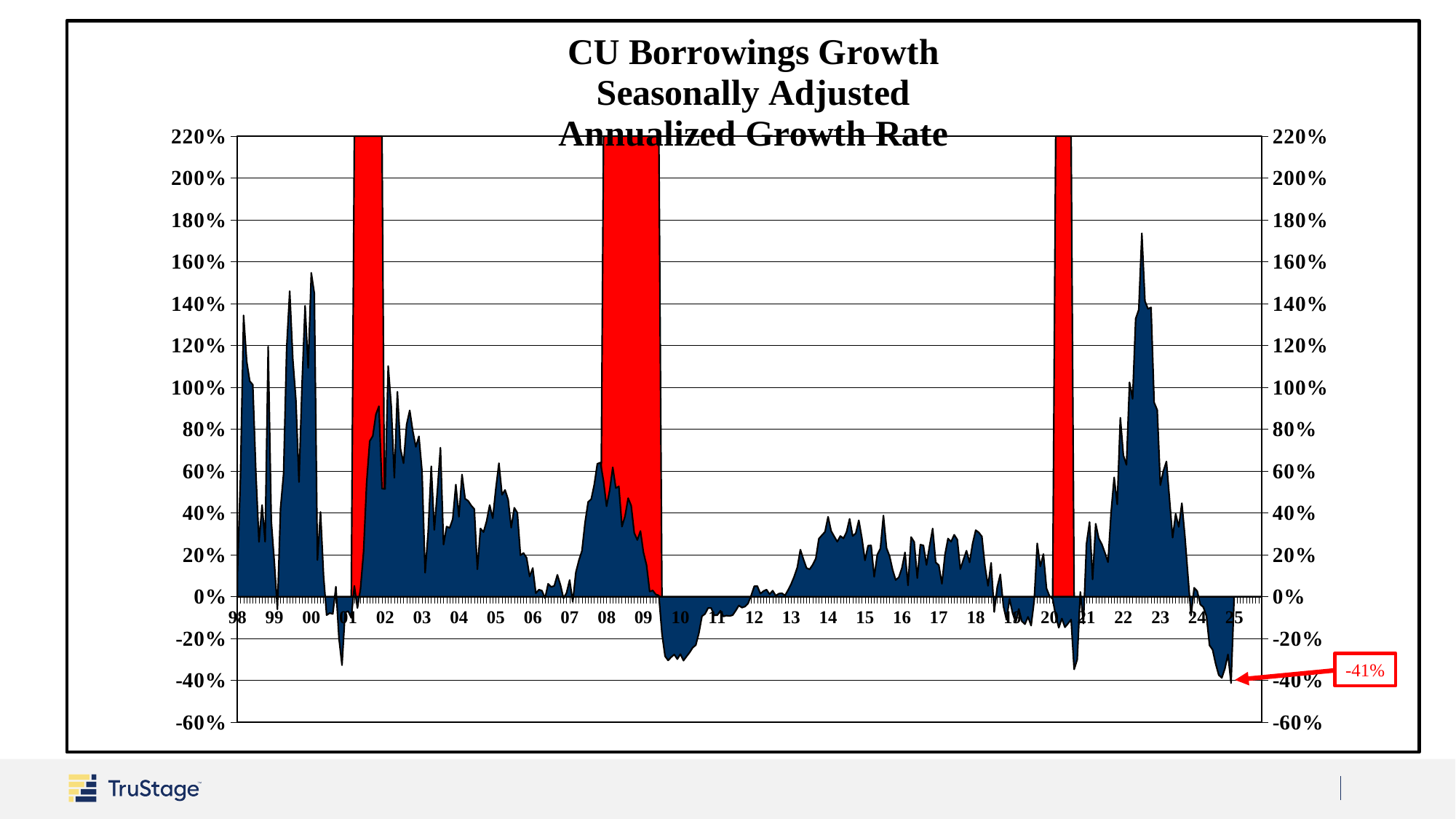
Is the peak value reached in 2000 greater or less than 140%? greater What is the title of the chart? CU Borrowings Growth Seasonally Adjusted Annualized Growth Rate Is the lowest value reached around 2010 greater or less than -20%? less Is the value during 2016 greater or less than 40%? less Which is higher: the peak around 2000 or the peak around 2022-23? The peak around 2022-23 What kind of chart is shown on the slide? Area chart What value does the callout label give for the latest data point in 2025? -41% How many year labels are shown on the x axis? 28 Which is lower: the trough around 2010 or the trough in 2025? The trough in 2025 How many red shaded bands appear on the chart? 3 Does the growth rate rise or fall from 2023 to 2025? Fall